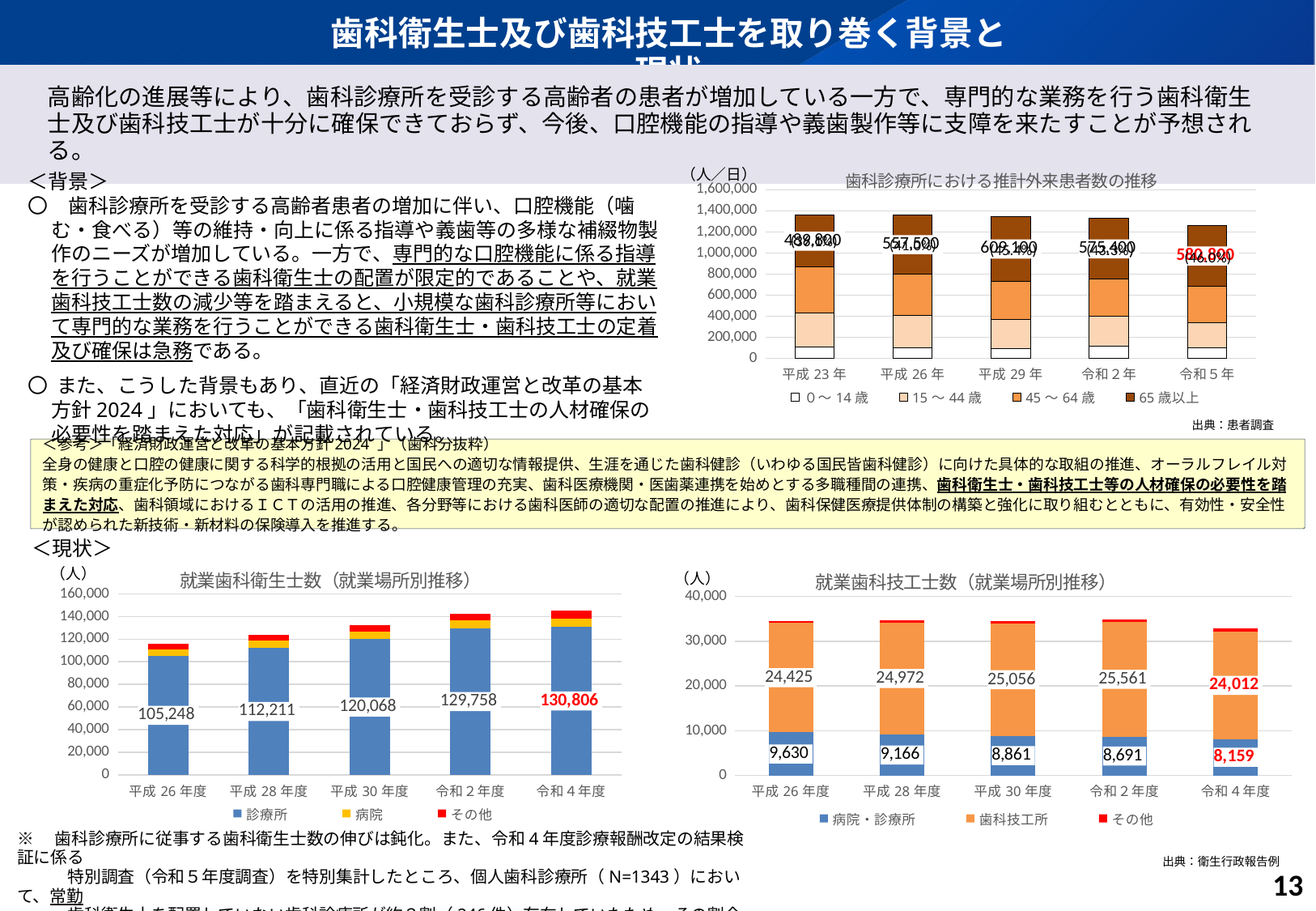
What kind of chart is the chart titled 歯科診療所における推計外来患者数の推移? stacked bar chart In the chart titled 就業歯科衛生士数（就業場所別推移）, do the 診療所 values rise or fall from 平成26年度 to 令和4年度? rise In the chart titled 就業歯科技工士数（就業場所別推移）, which is larger: the 病院・診療所 value in 平成26年度 or in 平成28年度? 平成26年度 In the chart titled 就業歯科衛生士数（就業場所別推移）, what is the value for 診療所 in 平成26年度? 105,248 In the chart titled 就業歯科技工士数（就業場所別推移）, what is the value for 歯科技工所 in 令和2年度? 25,561 In the chart titled 就業歯科技工士数（就業場所別推移）, what is the value for 病院・診療所 in 令和4年度? 8,159 In the chart titled 就業歯科技工士数（就業場所別推移）, which year has the highest 歯科技工所 value? 令和2年度 In the chart titled 就業歯科技工士数（就業場所別推移）, what is the difference between the 歯科技工所 values for 令和2年度 and 令和4年度? 1,549 How many series does the legend list in the chart titled 歯科診療所における推計外来患者数の推移? 4 In the chart titled 就業歯科衛生士数（就業場所別推移）, what is the value for 診療所 in 令和4年度? 130,806 In the chart titled 就業歯科衛生士数（就業場所別推移）, by how much did the 診療所 value increase from 平成26年度 to 令和4年度? 25,558 In the chart titled 就業歯科技工士数（就業場所別推移）, which year has the lowest 病院・診療所 value? 令和4年度